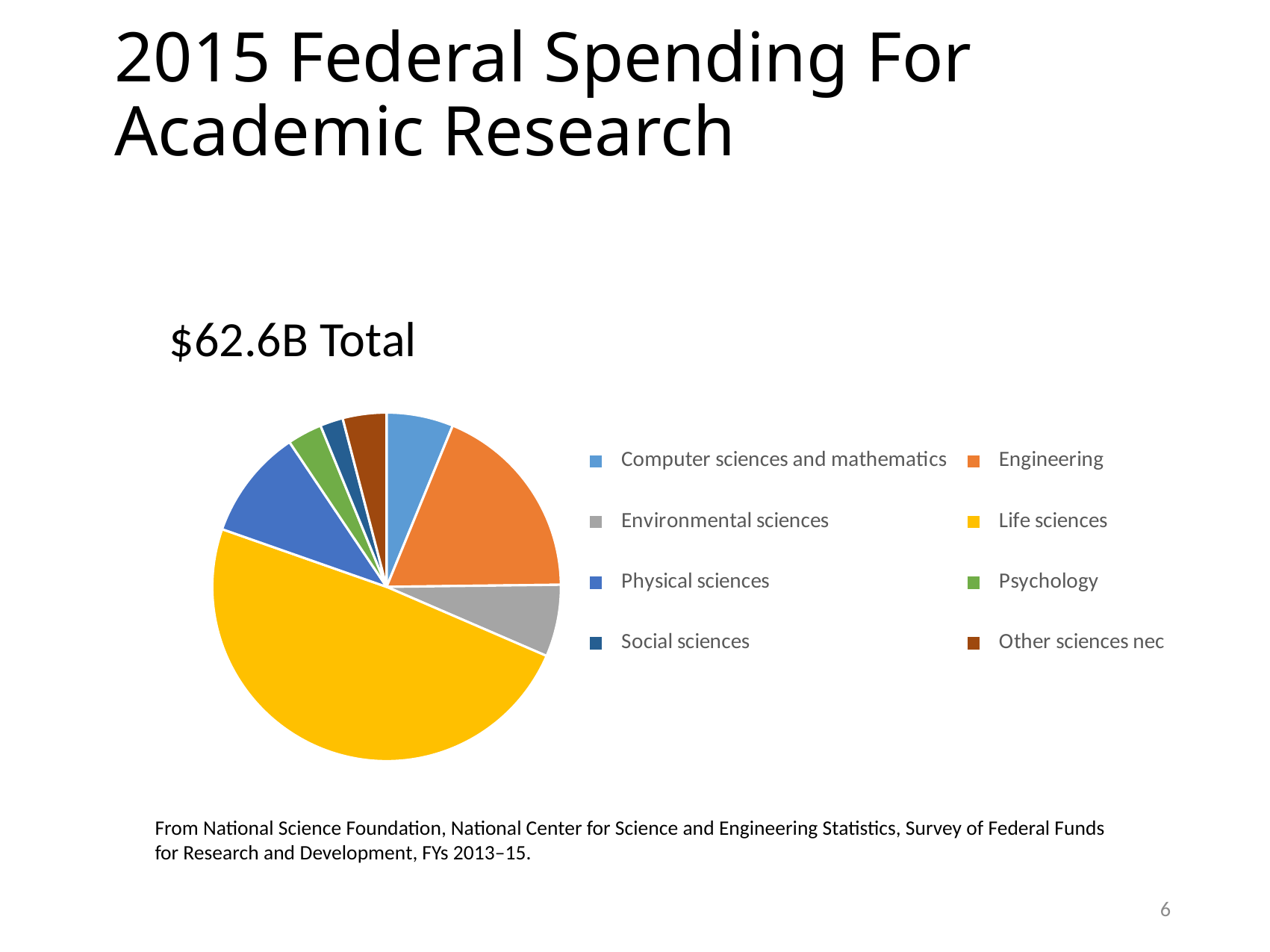
What kind of chart is shown on the slide? pie chart Which slice is larger, Environmental sciences or Social sciences? Environmental sciences Which slice is larger, Life sciences or Engineering? Life sciences Which slice is larger, Physical sciences or Psychology? Physical sciences What total amount of spending is stated above the pie chart? $62.6B Which category has the largest slice of the pie chart? Life sciences How many categories does the pie chart's legend list? 8 Which category is shown in yellow in the pie chart? Life sciences